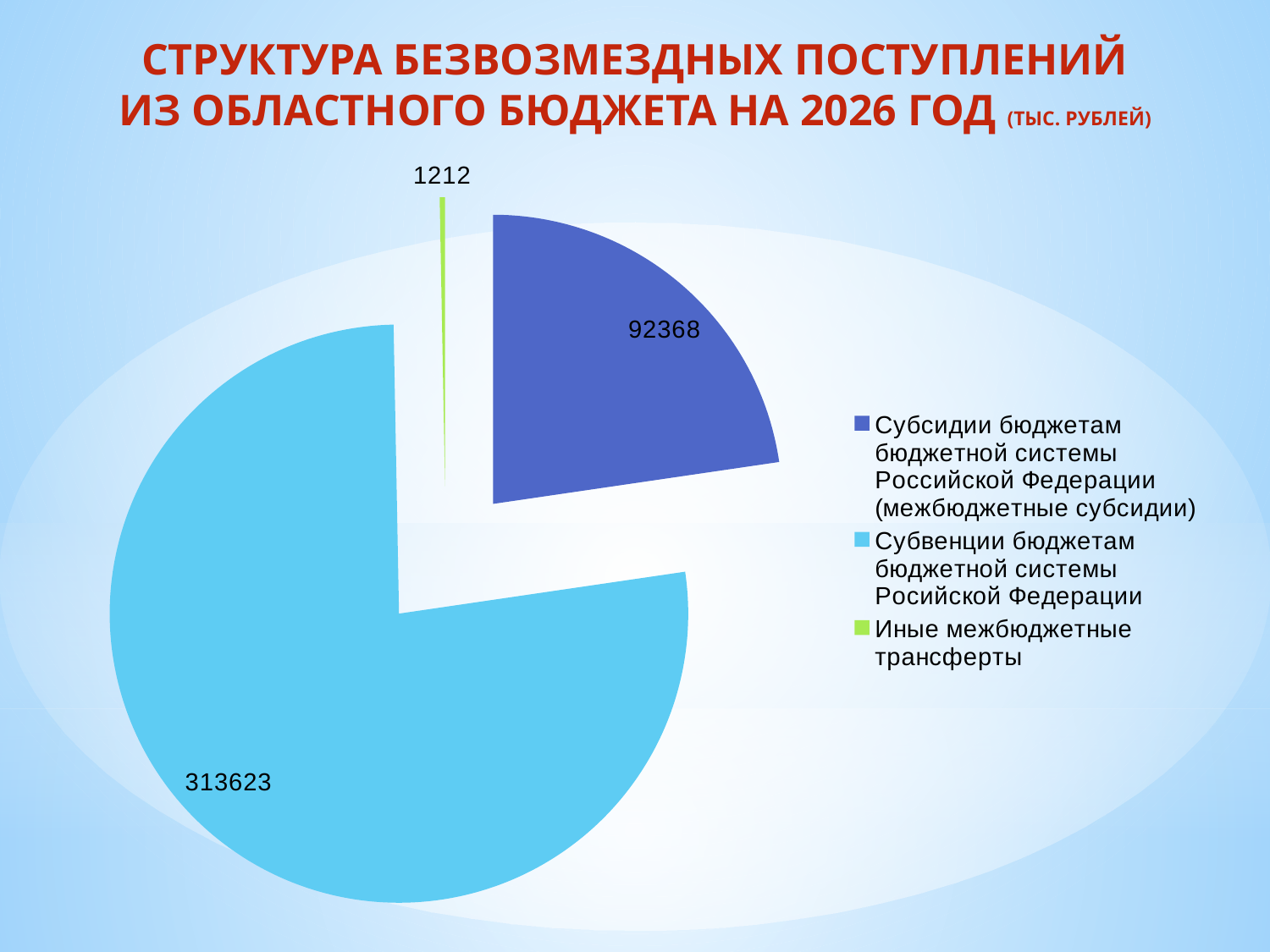
What type of chart is shown on the slide? pie chart Which category has the largest slice of the pie? Субвенции бюджетам бюджетной системы Росийской Федерации What colour is the slice for Иные межбюджетные трансферты? green Which is larger: the value for Субсидии or the value for Иные межбюджетные трансферты? Субсидии What is the total of all three slices in the pie chart? 407203 What is the difference between the value for Субвенции (313623) and the value for Субсидии (92368)? 221255 Which category has the smallest slice of the pie? Иные межбюджетные трансферты What is the value for Иные межбюджетные трансферты? 1212 What is the value for Субвенции бюджетам бюджетной системы Росийской Федерации? 313623 How many slices does the pie chart have? 3 What is the value for Субсидии бюджетам бюджетной системы Российской Федерации (межбюджетные субсидии)? 92368 What is the difference between the value for Субсидии (92368) and the value for Иные межбюджетные трансферты (1212)? 91156